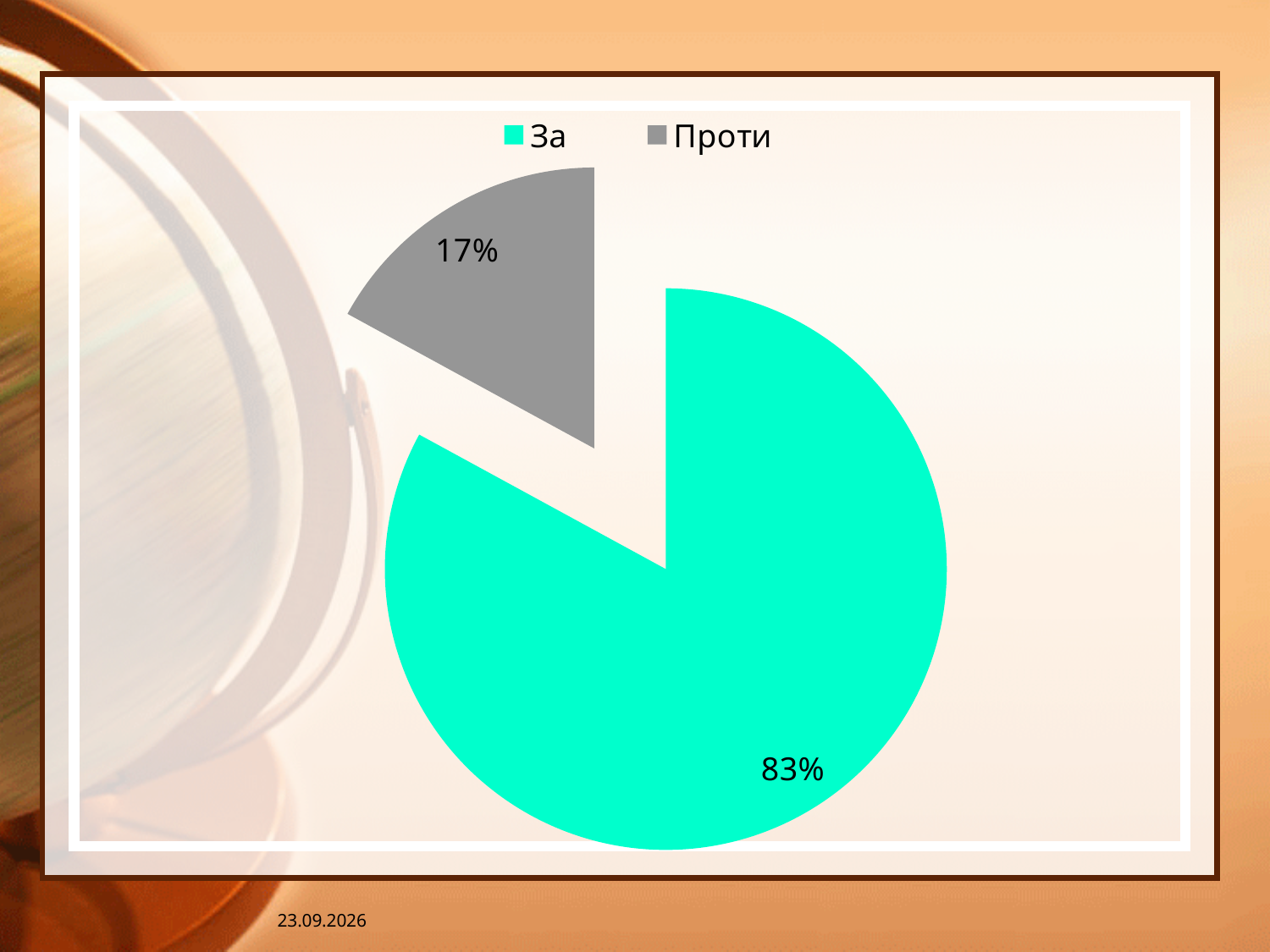
What is the difference in percentage points between the "За" and "Проти" slices? 66 What share of the pie does "Проти" represent? 17% What colour is the slice for "Проти"? grey What kind of chart is shown on the slide? pie chart What share of the pie does "За" represent? 83% Which is larger, the share for "За" or the share for "Проти"? За Which category has the largest slice of the pie? За What colour is the slice for "За"? turquoise Which category has the smallest slice of the pie? Проти How many slices does the pie chart have? 2 How many entries does the legend list? 2